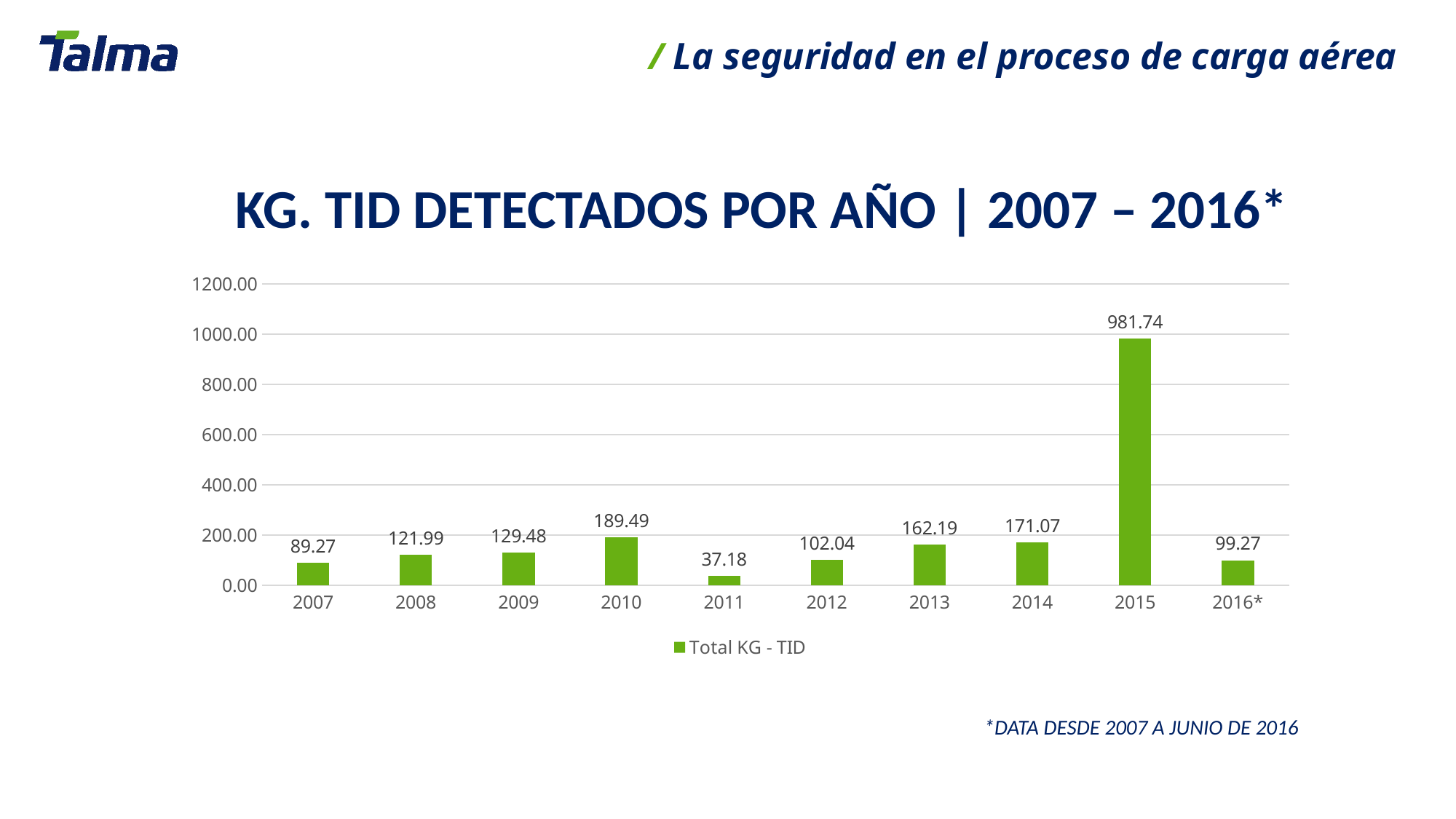
How many years are shown on the x axis? 10 How many series does the legend list? 1 Which year has the highest value? 2015 Which year has the lowest value? 2011 Is the value for 2015 greater or less than 800.00? greater What is the value for 2016*? 99.27 What is the difference between the values for 2014 and 2013? 8.88 Which is larger, the value for 2010 or the value for 2009? 2010 What kind of chart is shown? bar chart What is the value for 2015? 981.74 What is the value for 2011? 37.18 What is the legend entry for the series? Total KG - TID